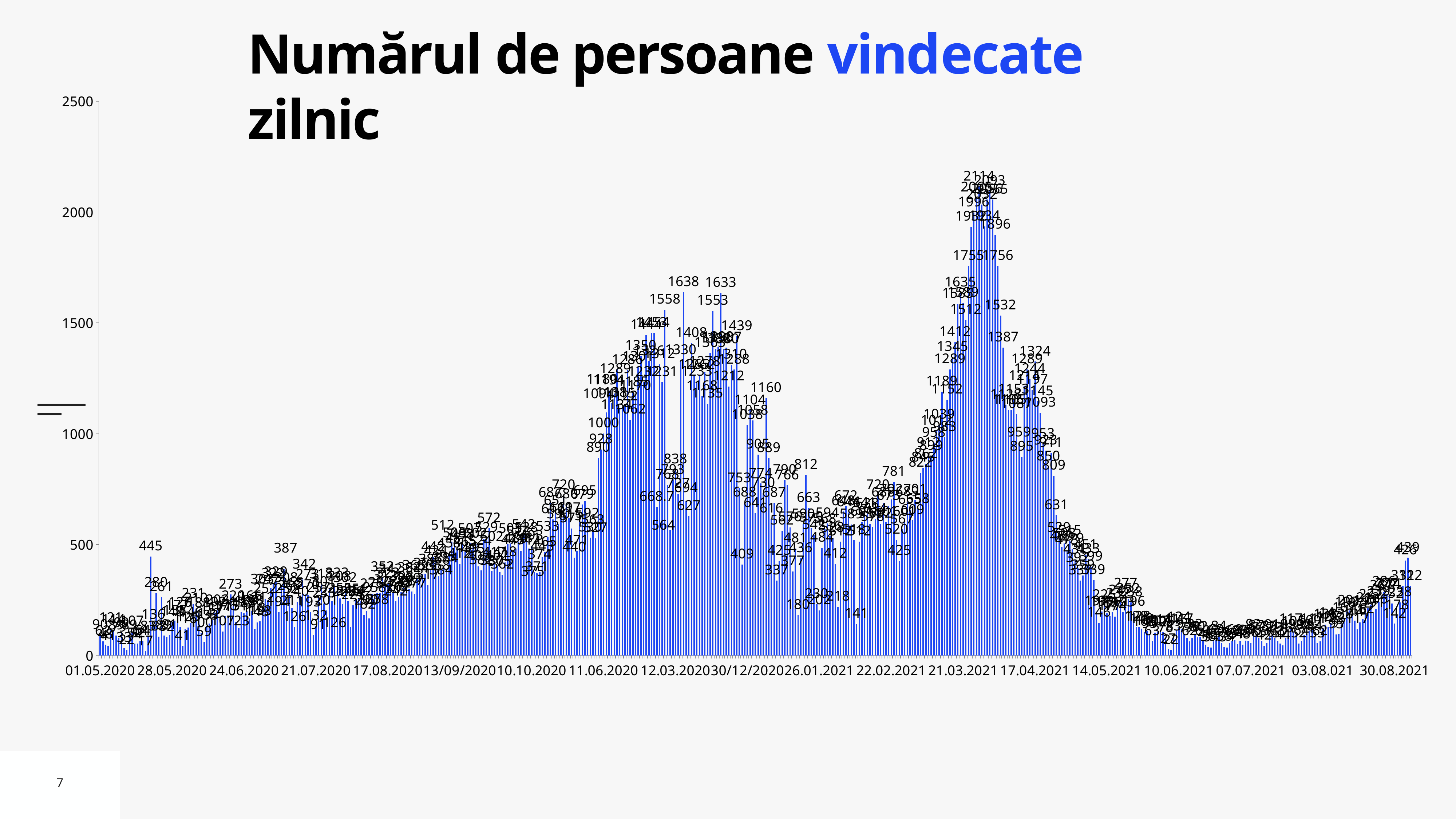
What is the title of the chart? Numărul de persoane vindecate zilnic What is the difference between the two labelled peaks 1638 and 1633? 5 Do the values rise or fall between 22.02.2021 and 21.03.2021? rise Do the values rise or fall between 03.08.2021 and 30.08.2021? rise What is the highest value shown on the vertical axis? 2500 What kind of chart is shown on the slide? bar chart Do the values rise or fall between 14.05.2021 and 10.06.2021? fall Is the tallest bar greater or less than 2000? greater What is the difference between the peak value 2114 and the earlier peak value 1638? 476 Is the value for the first bar at 01.05.2020 greater or less than 500? less What is the value of the tallest bar on the chart? 2114 Which peak is higher: the one labelled 1638 (around 12.03.2020) or the one labelled 2114 (around 21.03.2021–17.04.2021)? 2114